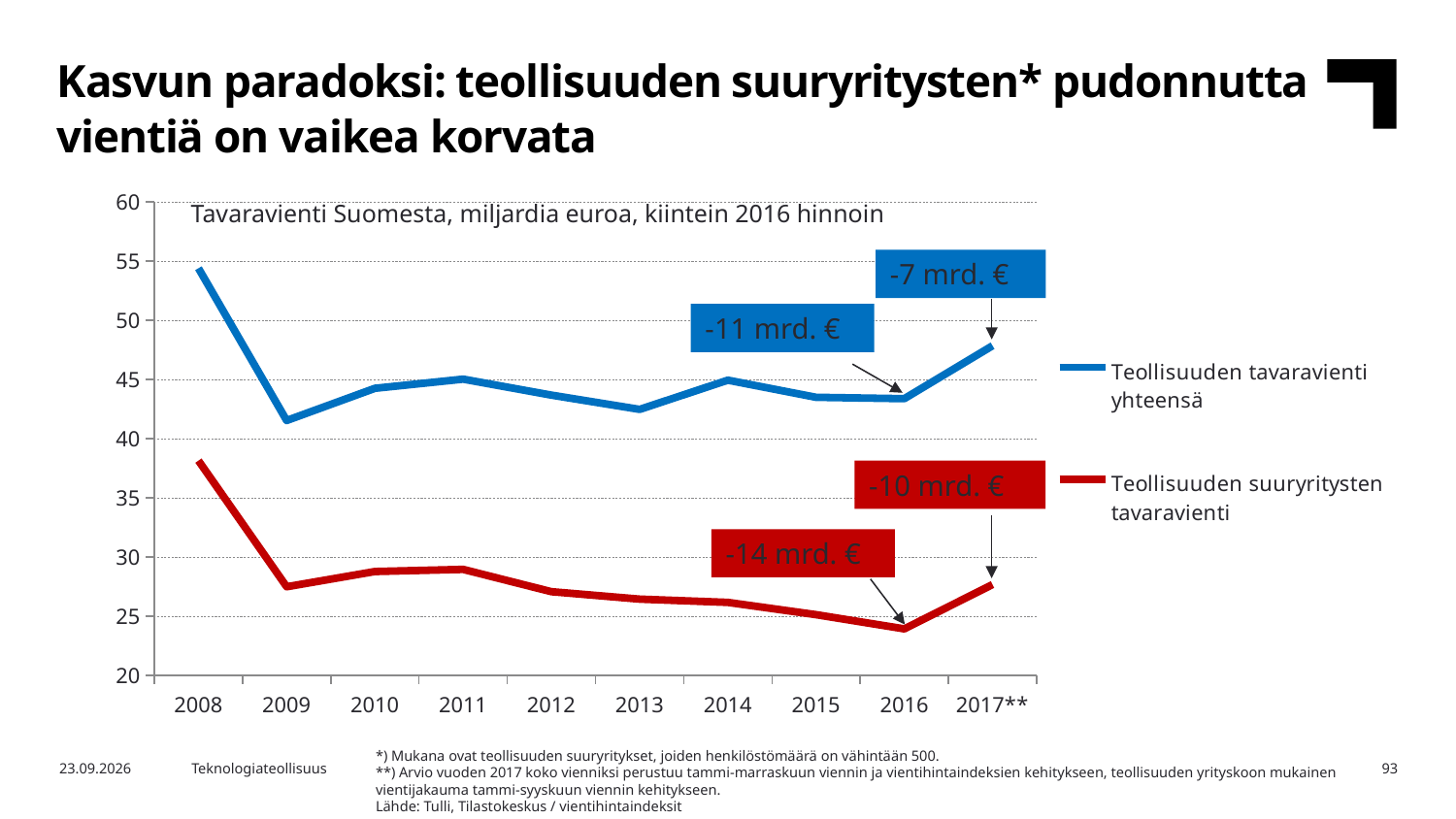
Is the value for Teollisuuden suuryritysten tavaravienti in 2008 greater or less than 35? greater In which year is Teollisuuden tavaravienti yhteensä highest? 2008 Is the value for Teollisuuden suuryritysten tavaravienti in 2016 greater or less than 25? less How many years are shown on the x axis? 10 How many series does the legend list? 2 What is the title of the chart? Tavaravienti Suomesta, miljardia euroa, kiintein 2016 hinnoin Which colour represents Teollisuuden suuryritysten tavaravienti? red In which year is Teollisuuden suuryritysten tavaravienti lowest? 2016 Which series has the larger value in 2014, Teollisuuden tavaravienti yhteensä or Teollisuuden suuryritysten tavaravienti? Teollisuuden tavaravienti yhteensä Do the values of Teollisuuden tavaravienti yhteensä rise or fall from 2008 to 2009? fall What kind of chart is shown on the slide? line chart Is the value for Teollisuuden tavaravienti yhteensä in 2008 greater or less than 50? greater